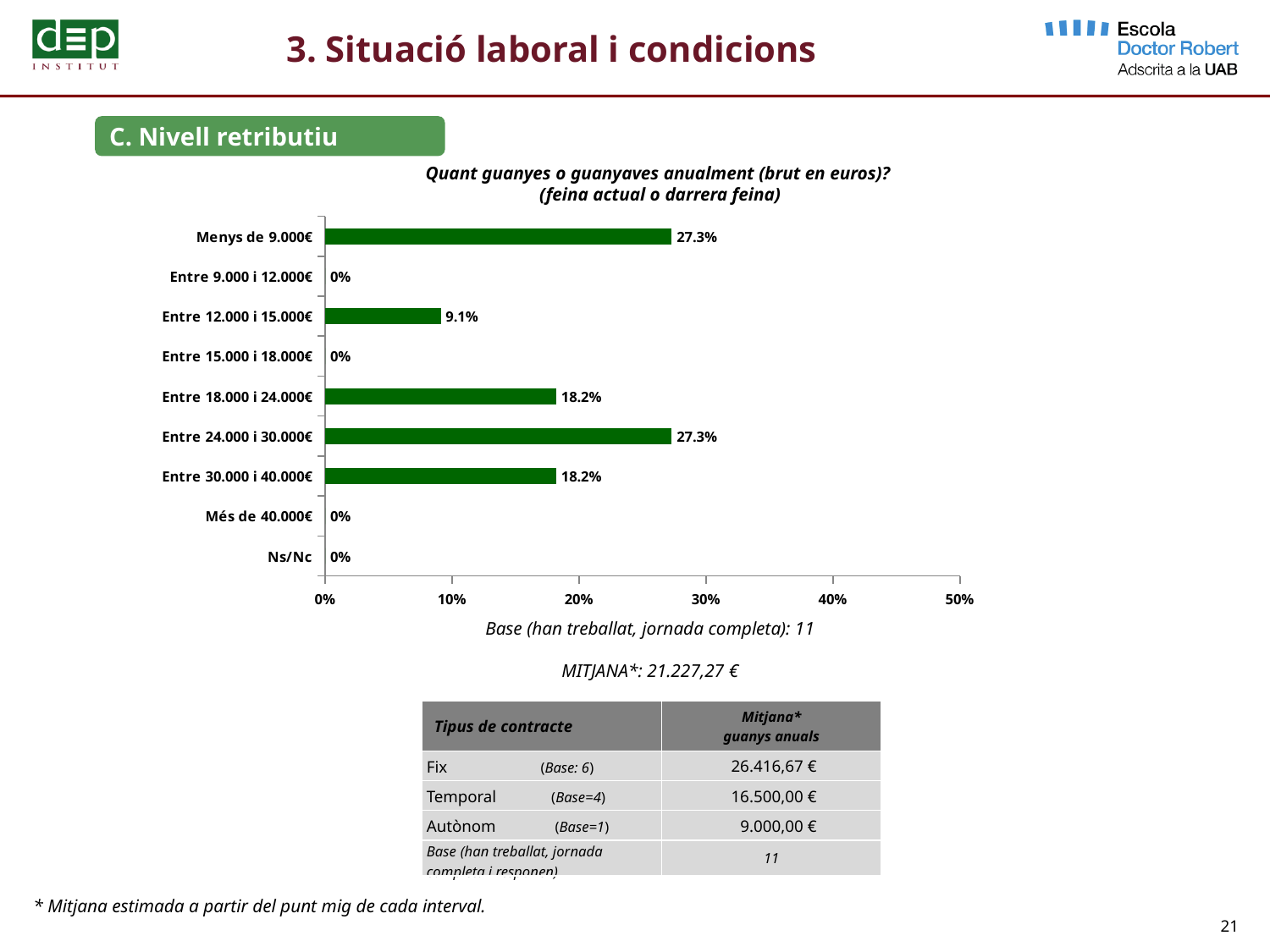
What is the difference between the values for "Entre 24.000 i 30.000€" and "Entre 30.000 i 40.000€"? 9.1% What is the base (number of respondents) stated below the chart? 11 Which is larger, the value for "Entre 12.000 i 15.000€" or the value for "Entre 18.000 i 24.000€"? Entre 18.000 i 24.000€ What type of chart is shown on the slide? Bar chart How many categories have a value of 0%? 4 How many categories are shown on the chart? 9 What is the value for "Més de 40.000€"? 0% What is the value for "Entre 12.000 i 15.000€"? 9.1% What is the value for "Menys de 9.000€"? 27.3% What is the value for "Entre 24.000 i 30.000€"? 27.3% What is the value for "Entre 18.000 i 24.000€"? 18.2% Is the value for "Menys de 9.000€" greater or less than 20%? greater